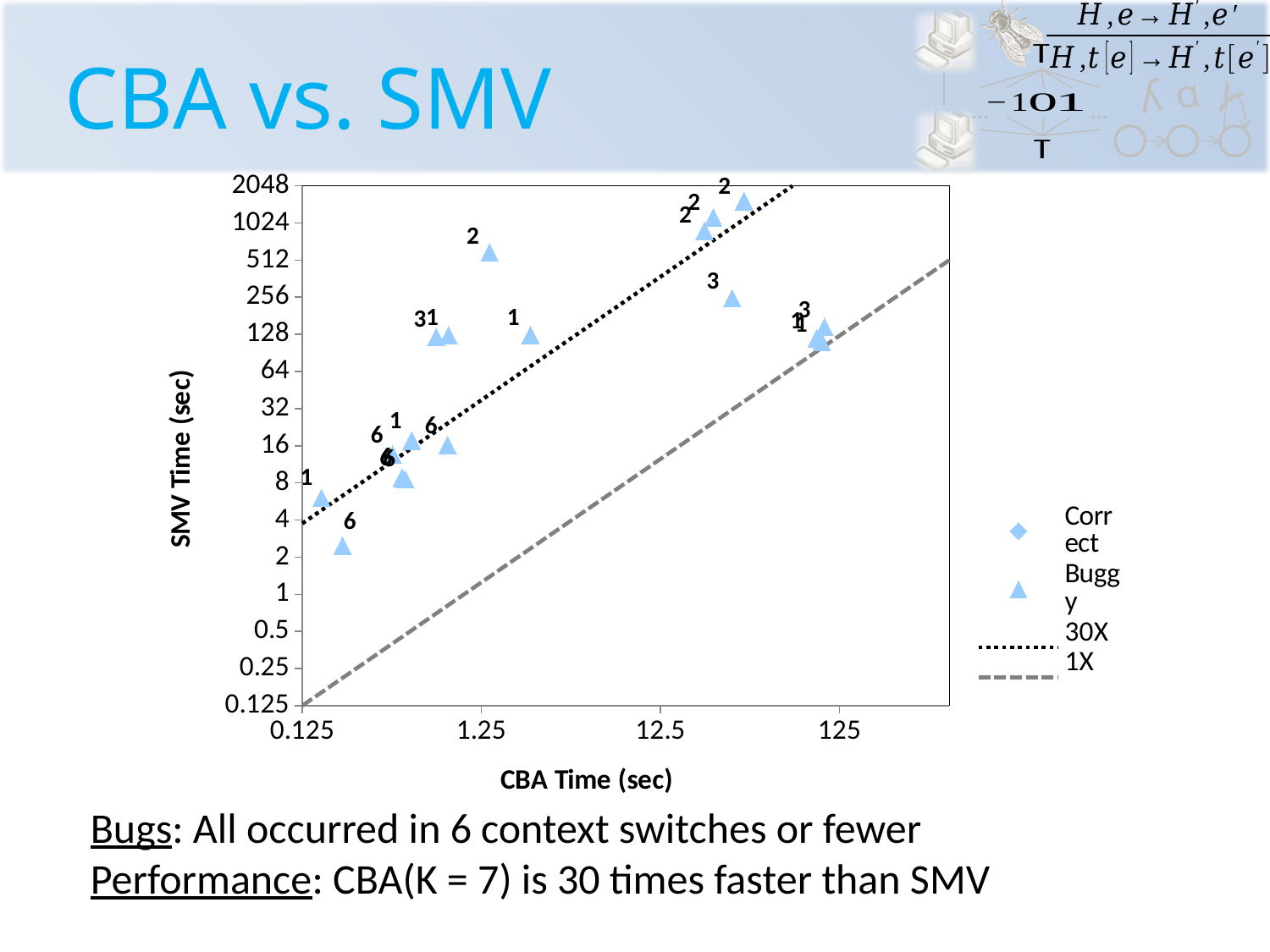
Is the SMV time of the lowest plotted point (labelled 6, near CBA time 0.2 sec) greater or less than 4? less Is the CBA time of the point labelled 3 near SMV time 256 sec greater or less than 12.5? greater What is the title of the vertical axis? SMV Time (sec) Do the plotted SMV times generally rise or fall as CBA time increases along the x axis? rise Is the SMV time of the highest plotted point (labelled 2, near CBA time 30 sec) greater or less than 1024? greater What is the highest tick value shown on the SMV Time axis? 2048 What is the highest tick value shown on the CBA Time axis? 125 What kind of chart is shown on the slide? Scatter chart How many entries does the chart legend list? 4